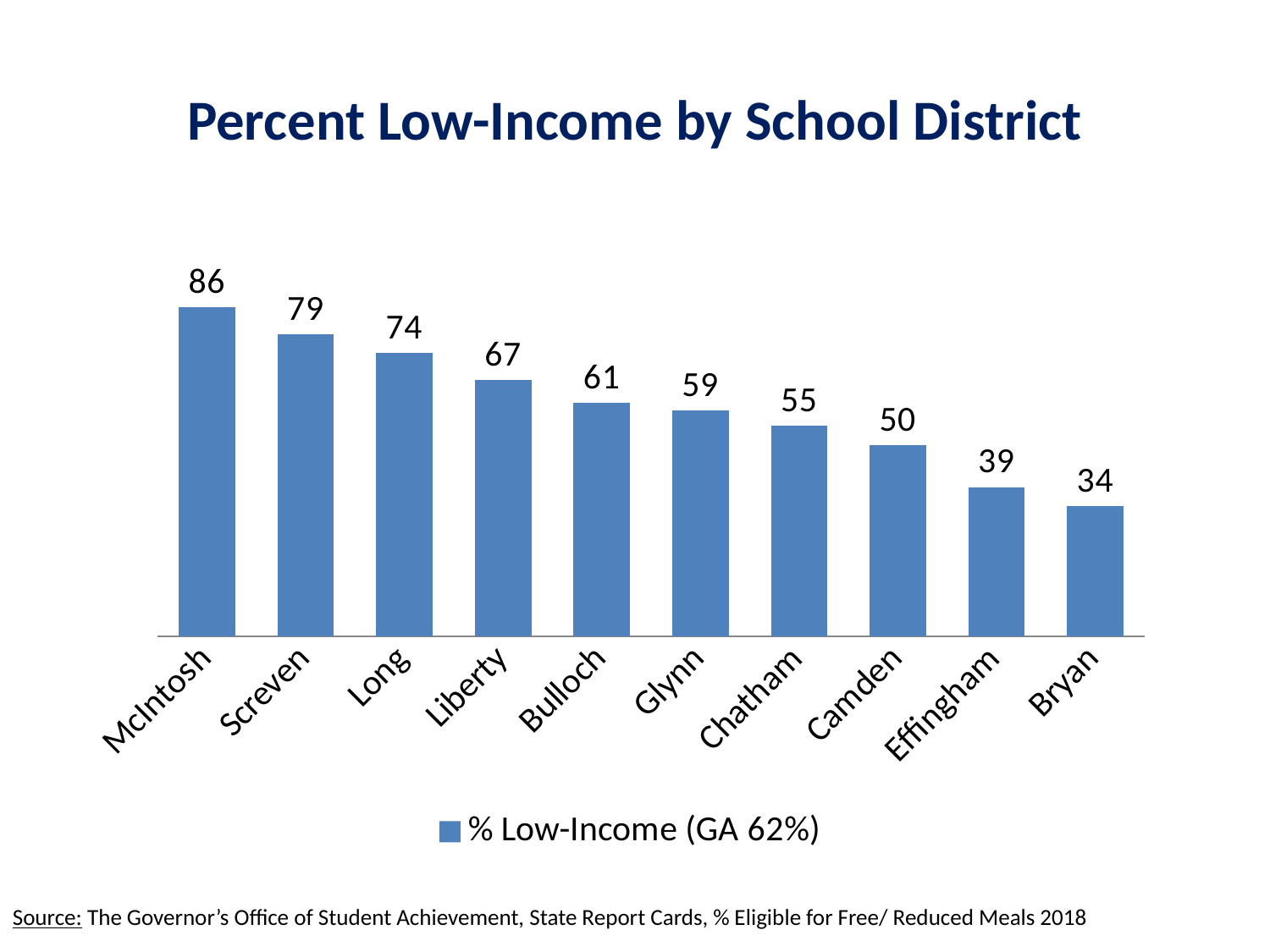
Do the values rise or fall from left to right along the x axis? fall What is the legend entry for the series shown? % Low-Income (GA 62%) What is the difference between the values for Screven and Long? 5 How many school districts are shown on the chart? 10 Which school district has the lowest value? Bryan Which is larger, the value for Bulloch or the value for Camden? Bulloch Which school district has the highest value? McIntosh What is the value for Effingham? 39 What kind of chart is this? bar chart What is the difference between the values for McIntosh and Bryan? 52 What is the value for Chatham? 55 What is the value for McIntosh? 86